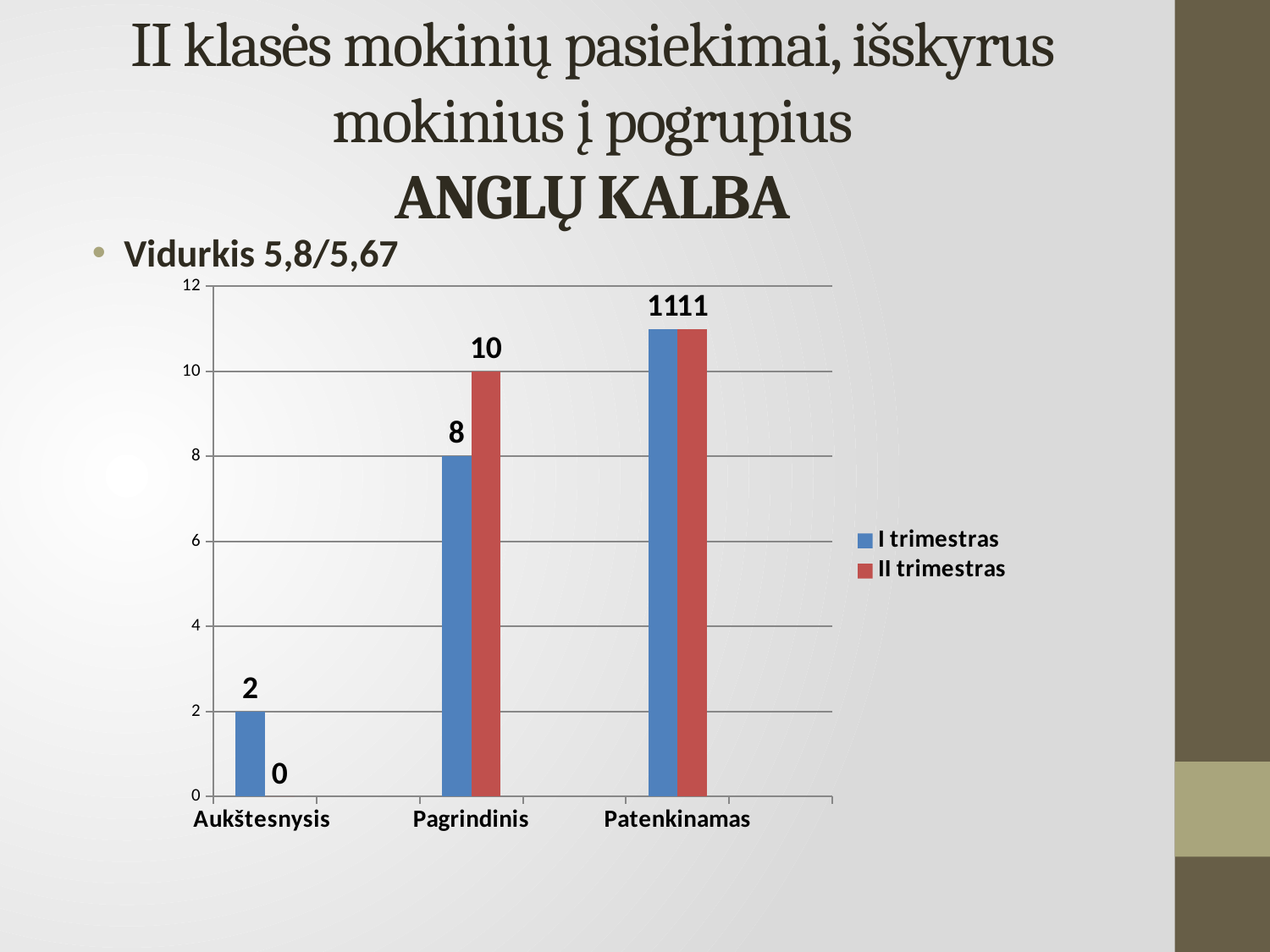
How many categories are shown on the x axis? 3 Which category has the highest value in the II trimestras series? Patenkinamas Which is larger for Pagrindinis: the I trimestras value or the II trimestras value? II trimestras What is the value for Aukštesnysis in the I trimestras series? 2 What kind of chart is shown on the slide? bar chart What is the difference between the II trimestras and I trimestras values for Pagrindinis? 2 How many series does the legend list? 2 What is the value for Patenkinamas in the I trimestras series? 11 Which category has the lowest value in the I trimestras series? Aukštesnysis What is the value for Aukštesnysis in the II trimestras series? 0 What is the value for Pagrindinis in the I trimestras series? 8 What is the value for Pagrindinis in the II trimestras series? 10